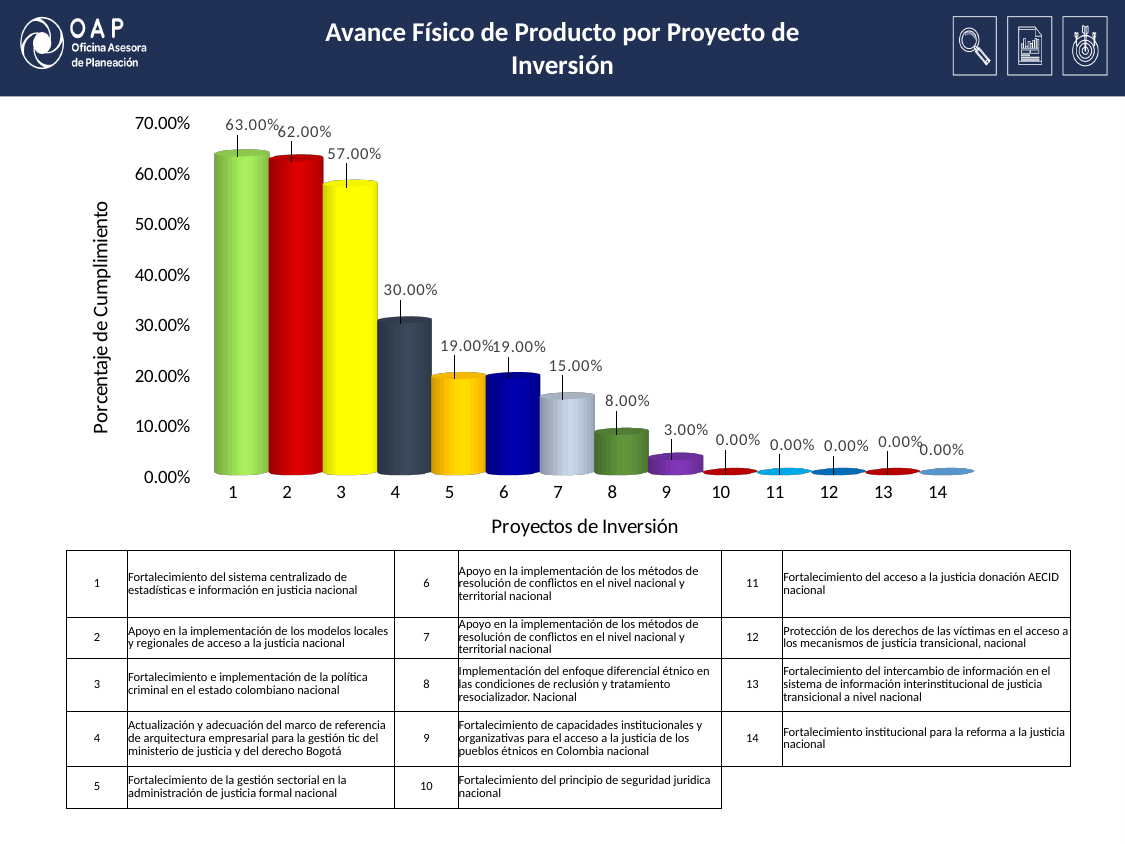
Do the values rise or fall from project 1 to project 14? fall What is the value for project 4? 30.00% What is the difference between the values for project 4 and project 8? 22.00% What kind of chart is shown? bar chart What is the value for project 9? 3.00% What is the value for project 7? 15.00% Is the value for project 3 greater or less than 50.00%? greater What is the difference between the values for project 1 and project 3? 6.00% What is the label of the y axis? Porcentaje de Cumplimiento Which is larger, the value for project 2 or the value for project 5? project 2 Which project has the highest value? 1 How many projects are shown on the x axis? 14